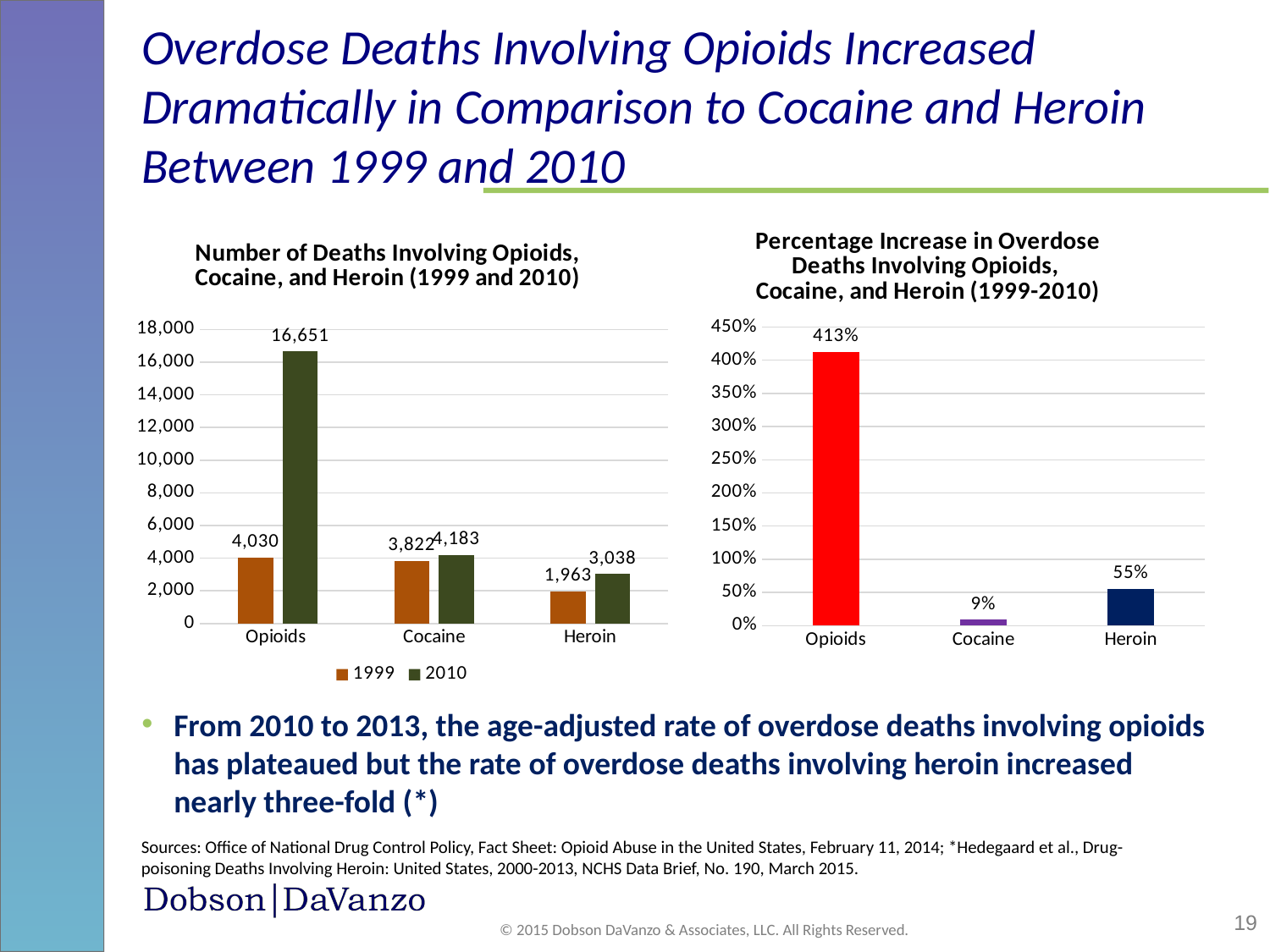
In the left chart (Number of Deaths Involving Opioids, Cocaine, and Heroin), which category has the lowest value in 1999? Heroin In the left chart (Number of Deaths Involving Opioids, Cocaine, and Heroin), what is the number of deaths involving cocaine in 2010? 4,183 In the left chart (Number of Deaths Involving Opioids, Cocaine, and Heroin), what is the number of deaths involving opioids in 2010? 16,651 What kind of chart is the right chart (Percentage Increase in Overdose Deaths)? Bar chart In the left chart (Number of Deaths Involving Opioids, Cocaine, and Heroin), what is the number of deaths involving heroin in 1999? 1,963 In the right chart (Percentage Increase in Overdose Deaths), what is the percentage increase for heroin? 55% In the left chart (Number of Deaths Involving Opioids, Cocaine, and Heroin), what is the difference between opioid deaths in 2010 and 1999? 12,621 In the left chart (Number of Deaths Involving Opioids, Cocaine, and Heroin), how many series does the legend list? 2 In the right chart (Percentage Increase in Overdose Deaths), what is the percentage increase for cocaine? 9% In the right chart (Percentage Increase in Overdose Deaths), which category has the highest percentage increase? Opioids In the left chart (Number of Deaths Involving Opioids, Cocaine, and Heroin), which category has the highest value in 2010? Opioids In the right chart (Percentage Increase in Overdose Deaths), how many categories are shown on the x axis? 3